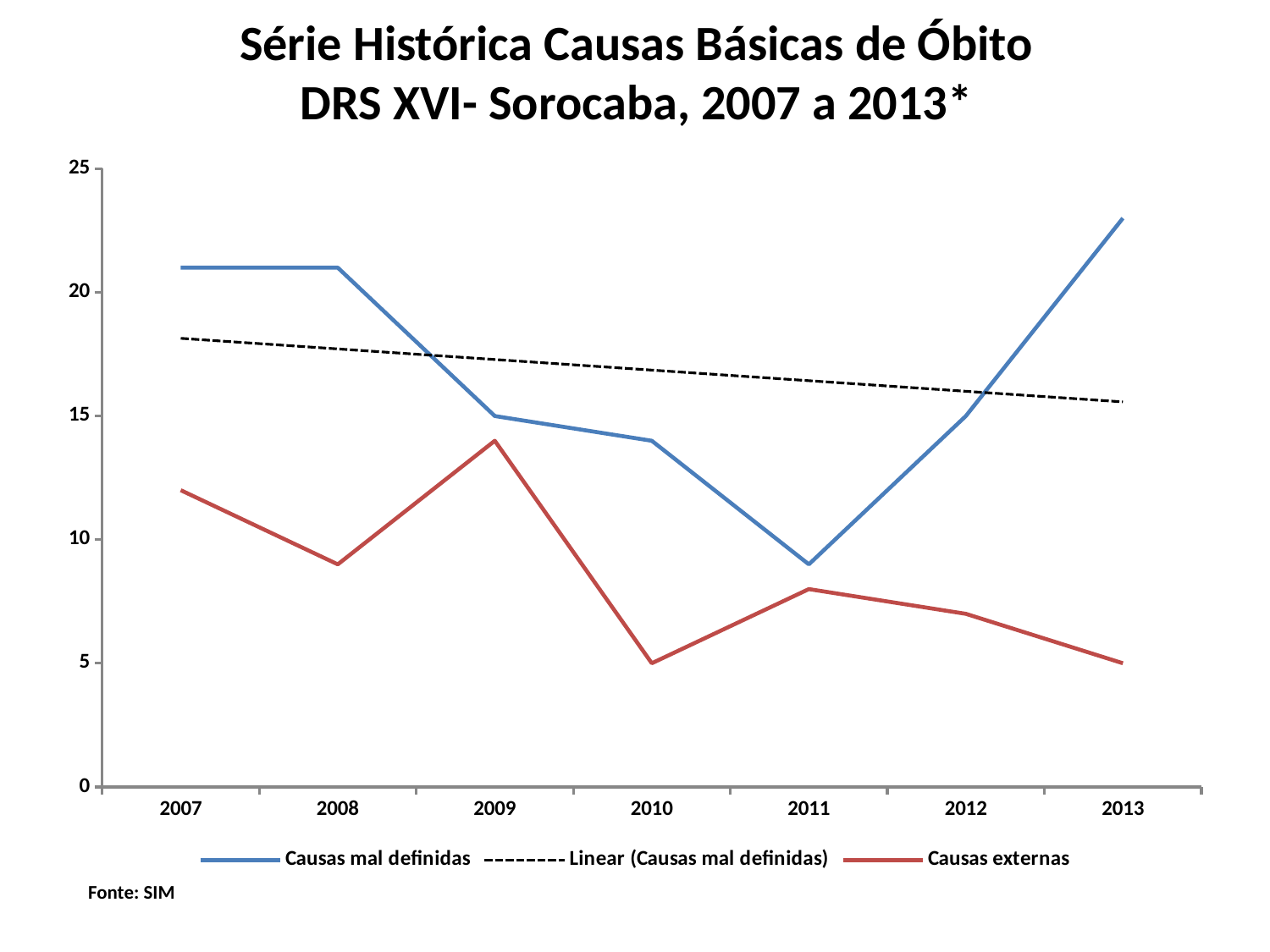
In which year is the value for Causas mal definidas lowest? 2011 How many years are plotted along the x axis? 7 Is the value for Causas mal definidas in 2007 greater or less than 20? greater How many series does the legend list? 3 In 2013, which series has the larger value, Causas mal definidas or Causas externas? Causas mal definidas Is the value for Causas mal definidas in 2013 greater or less than 20? greater Does the dashed Linear (Causas mal definidas) trendline rise or fall from 2007 to 2013? fall In which year is the value for Causas externas highest? 2009 Is the value for Causas externas in 2011 greater or less than 10? less In which year is the value for Causas mal definidas highest? 2013 What kind of chart is shown on the slide? line chart What is the source cited below the chart? SIM